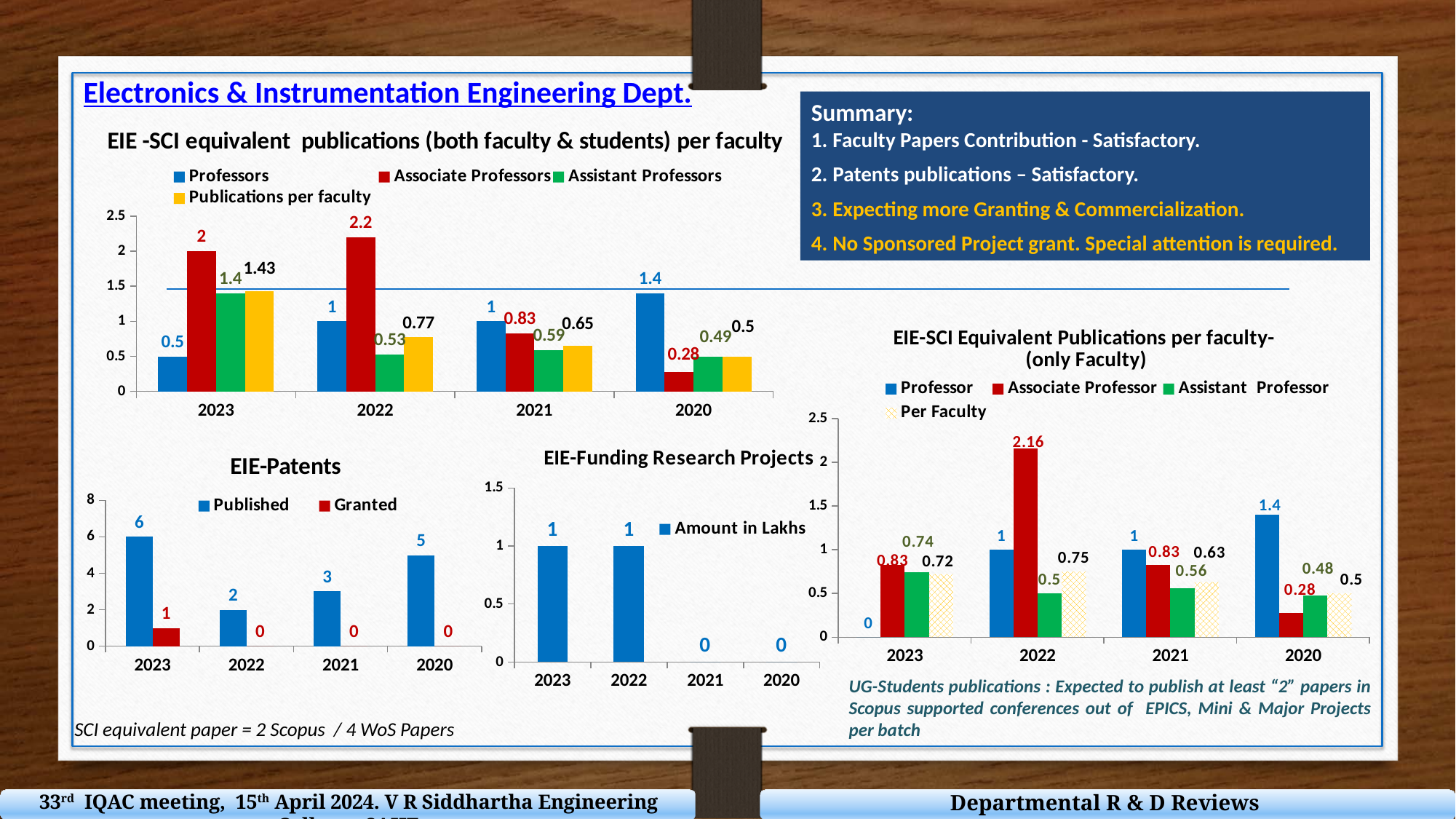
What kind of chart is the EIE-Patents chart? Bar chart How many series does the legend of the EIE-SCI Equivalent Publications per faculty (only Faculty) chart list? 4 How many series does the legend of the EIE-Funding Research Projects chart list? 1 In the EIE-Patents chart, how many patents were published in 2023? 6 In the EIE -SCI equivalent publications (both faculty & students) per faculty chart, what is the value for Associate Professors in 2022? 2.2 In the EIE-Patents chart, which year has the lowest number of published patents? 2022 In the EIE-SCI Equivalent Publications per faculty (only Faculty) chart, what is the Per Faculty value for 2021? 0.63 In the EIE-SCI Equivalent Publications per faculty (only Faculty) chart, what is the value for Associate Professor in 2022? 2.16 In the EIE -SCI equivalent publications (both faculty & students) per faculty chart, which year has the highest Publications per faculty value? 2023 In the EIE-Patents chart, what is the difference between published and granted patents in 2023? 5 In the EIE-Funding Research Projects chart, what is the amount in lakhs for 2021? 0 In the EIE -SCI equivalent publications (both faculty & students) per faculty chart, which is larger in 2020: Professors or Assistant Professors? Professors